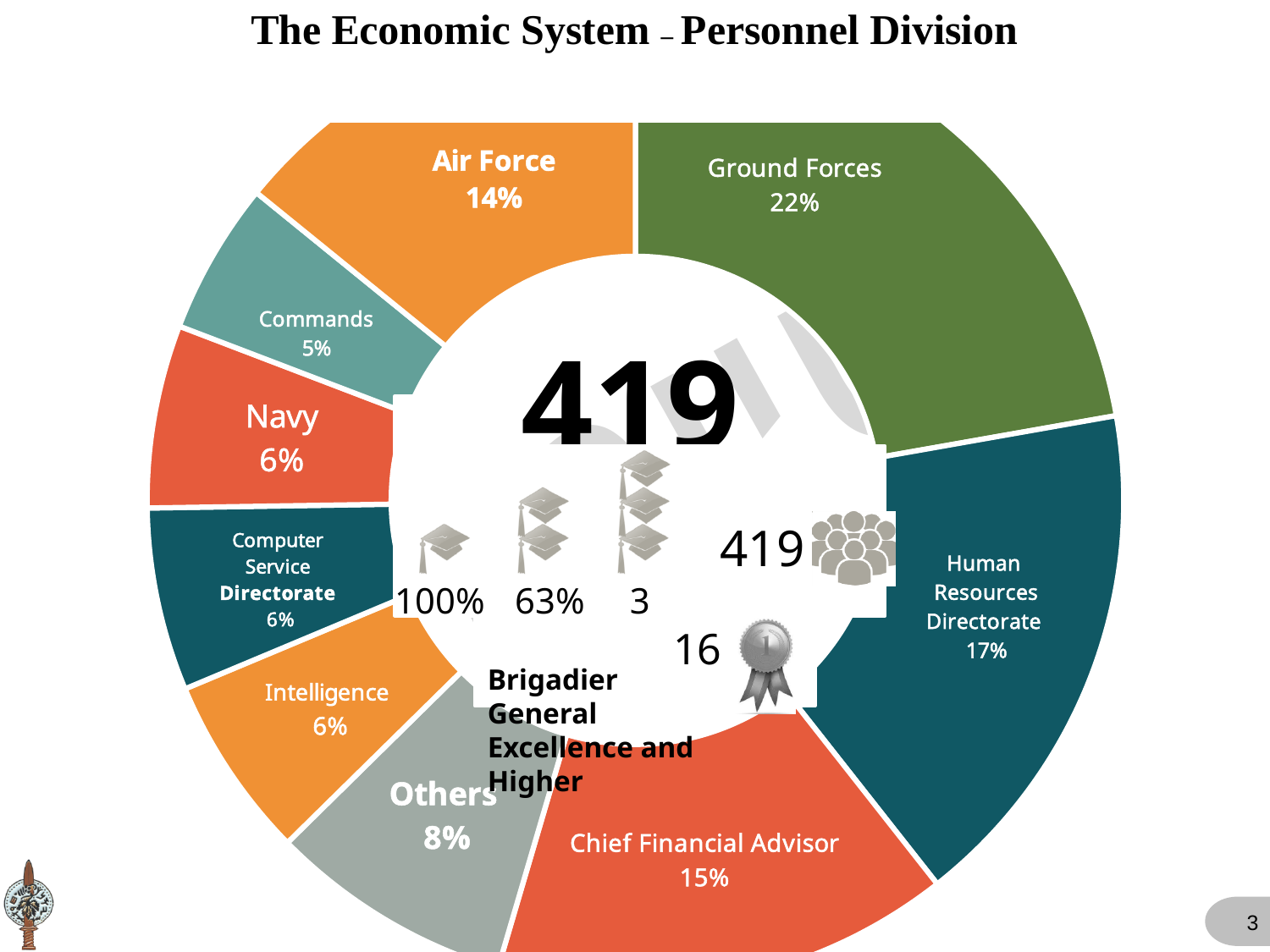
Which segment has the smallest share of the chart? Commands Which is larger, the Human Resources Directorate share or the Chief Financial Advisor share? Human Resources Directorate What kind of chart is shown on the slide? Donut (pie) chart What percentage does the Human Resources Directorate segment show? 17% What number is displayed in the centre of the donut chart? 419 How many segments does the donut chart have? 9 What percentage does the Ground Forces segment show? 22% What is the difference in percentage points between Ground Forces and Air Force? 8 What percentage is shown for the Air Force segment? 14% What percentage is shown for the Others segment? 8% What percentage is shown for the Chief Financial Advisor segment? 15% Which segment has the largest share of the chart? Ground Forces